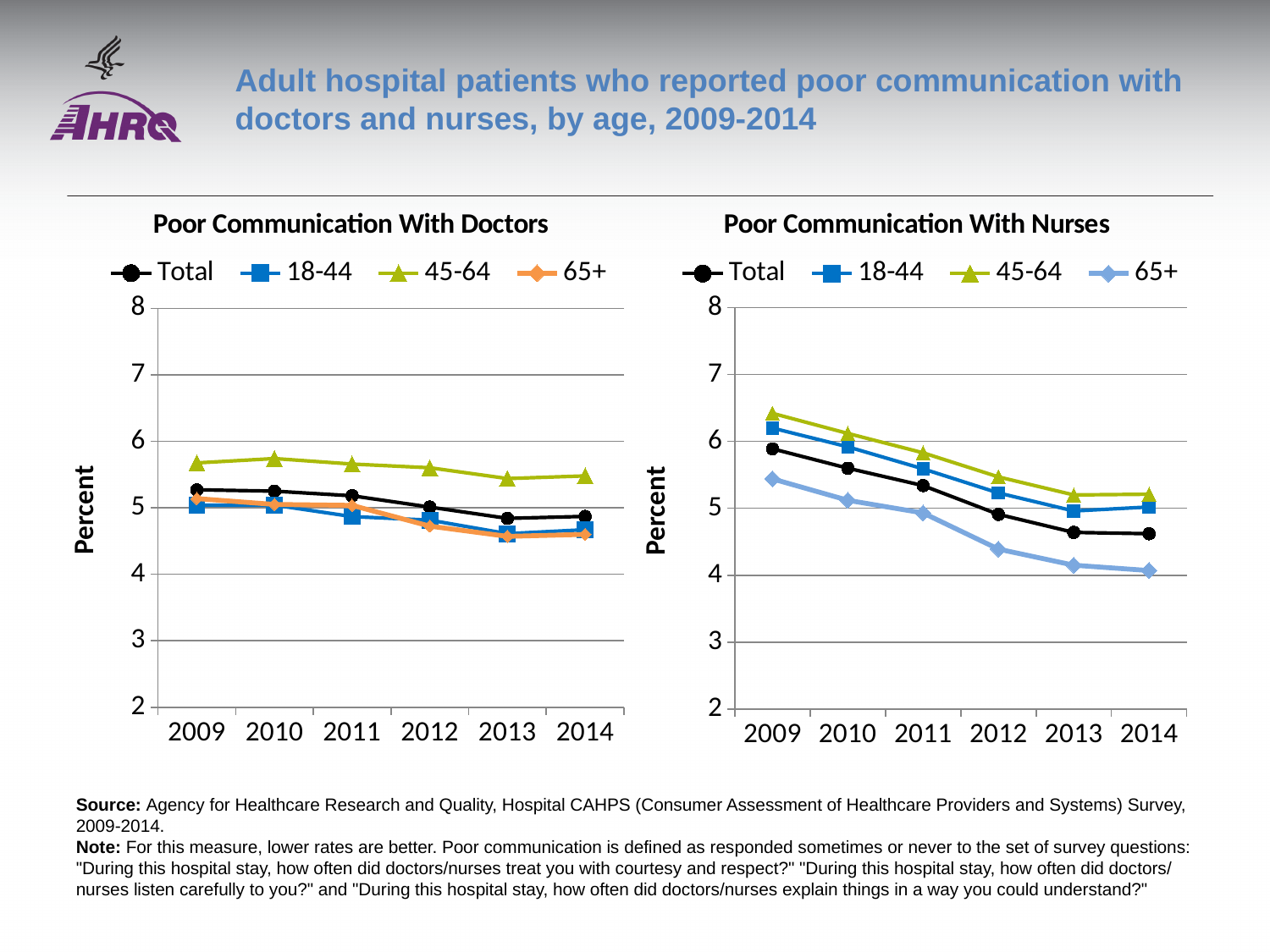
In the "Poor Communication With Nurses" chart, is the value for 45-64 in 2009 greater or less than 6? greater In the "Poor Communication With Nurses" chart, which age group has the lowest value in 2014? 65+ In the "Poor Communication With Nurses" chart, is the value for 65+ in 2014 greater or less than 5? less What is the label on the y axis of the "Poor Communication With Doctors" chart? Percent In the "Poor Communication With Nurses" chart, does the Total line rise or fall from 2009 to 2014? fall In the "Poor Communication With Nurses" chart, which age group has the highest value in 2009? 45-64 What kind of chart is the "Poor Communication With Doctors" chart? line chart In the "Poor Communication With Doctors" chart, which age group has the highest values across all years? 45-64 How many years are shown on the x axis of the "Poor Communication With Doctors" chart? 6 In the "Poor Communication With Nurses" chart, which is larger in 2014: the value for 18-44 or the value for Total? 18-44 In the "Poor Communication With Doctors" chart, is the value for 65+ in 2013 greater or less than 5? less How many series does the legend of the "Poor Communication With Nurses" chart list? 4